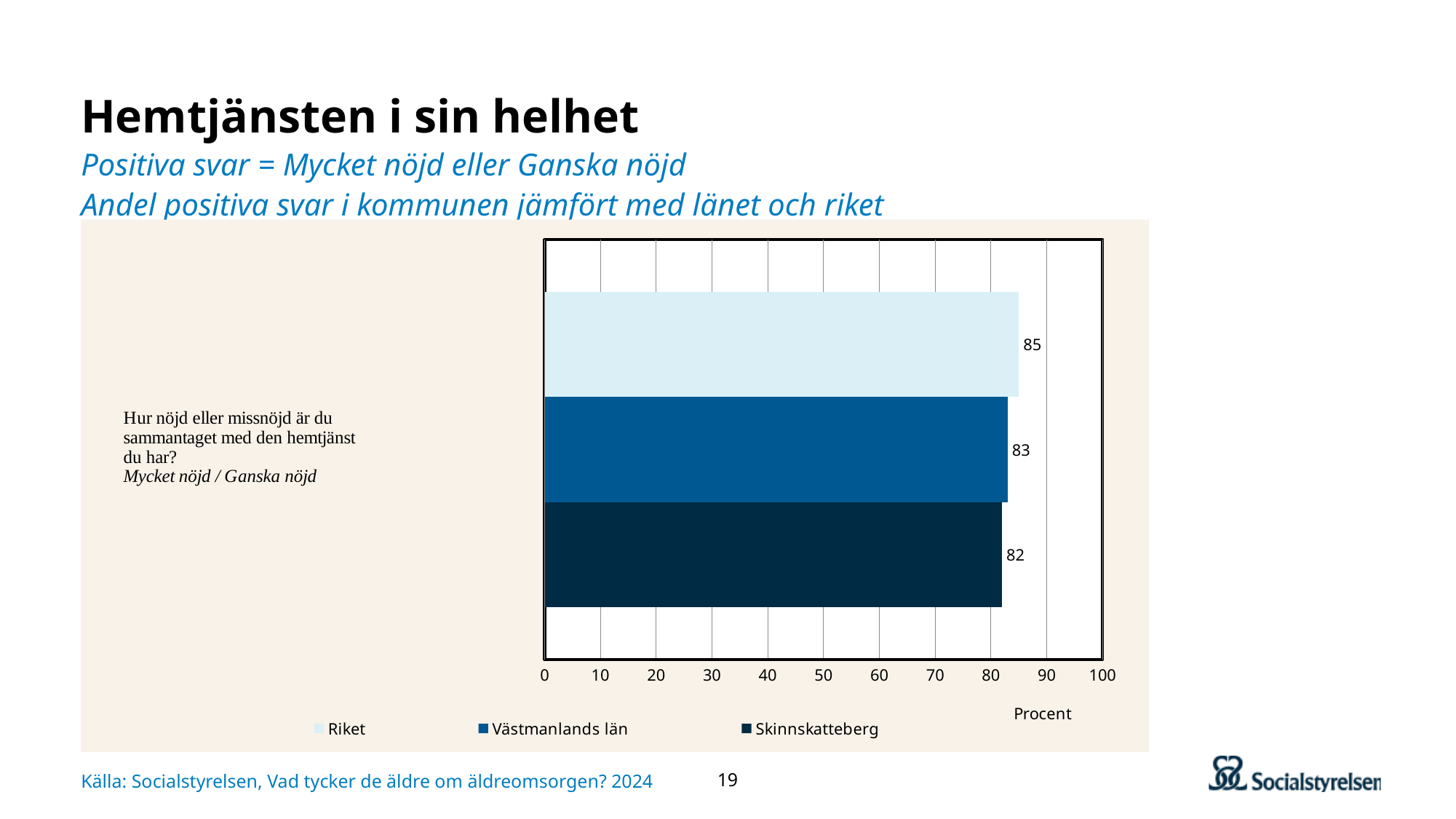
What is the value for Skinnskatteberg? 82 What kind of chart is shown on the slide? bar chart What unit label is shown below the x axis? Procent How many series does the legend list? 3 Which is larger, the value for Riket or the value for Västmanlands län? Riket What is the difference between the values for Riket and Skinnskatteberg? 3 Which series has the lowest value? Skinnskatteberg What is the difference between the values for Västmanlands län and Skinnskatteberg? 1 Is the value for Skinnskatteberg greater or less than 90? less What is the value for Västmanlands län? 83 Which series has the highest value? Riket What is the value for Riket? 85